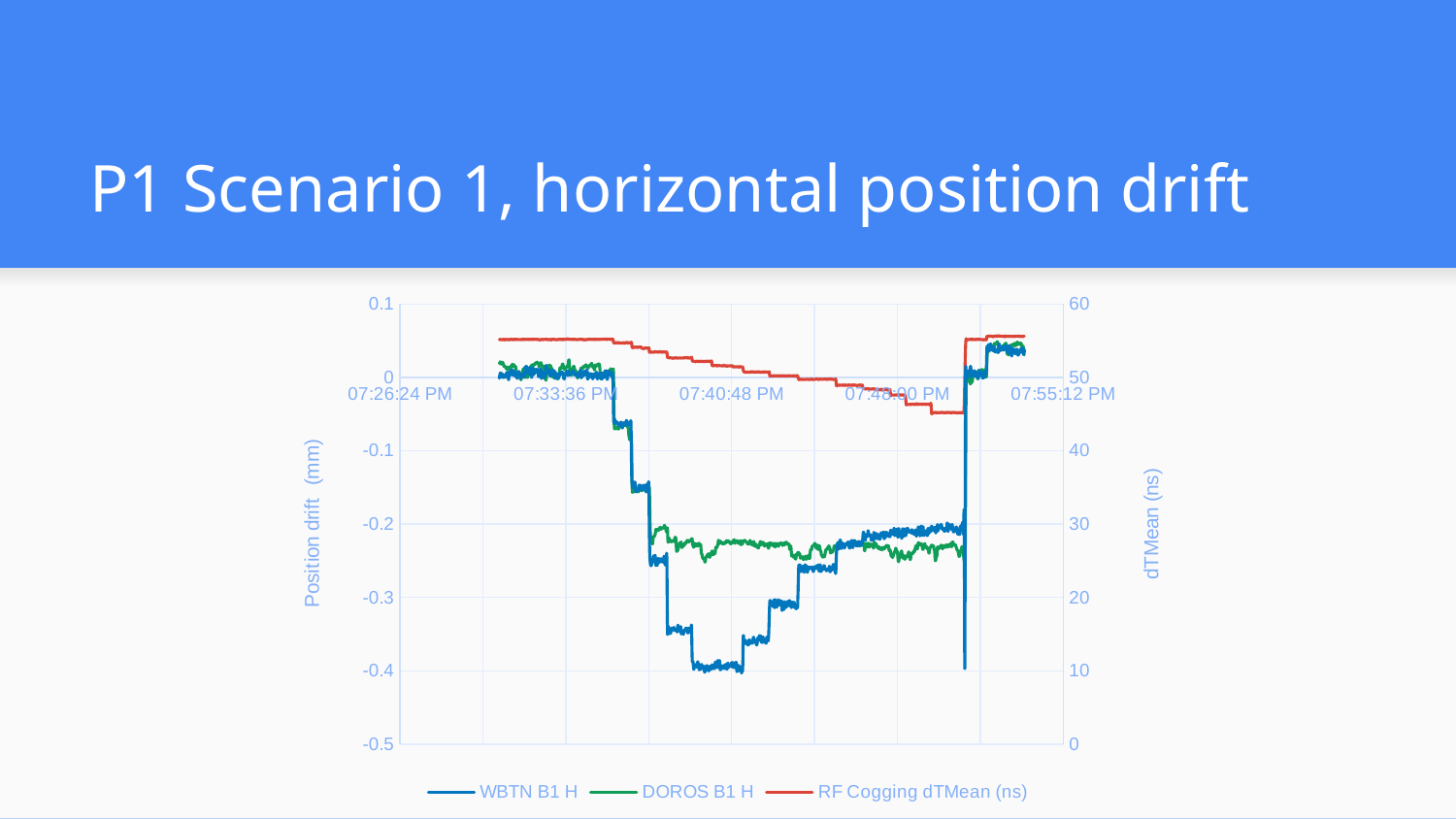
What kind of chart is shown on the slide? line chart Is the value of the RF Cogging dTMean series at 07:33:36 PM greater or less than 50? greater Is the value of the DOROS B1 H series at 07:40:48 PM greater or less than -0.1? less How many series does the chart legend list? 3 Is the lowest value reached by the RF Cogging dTMean series greater or less than 50? less What are the three series named in the legend? WBTN B1 H, DOROS B1 H, RF Cogging dTMean (ns) Between 07:33:36 PM and 07:48:00 PM, does the RF Cogging dTMean series rise or fall? fall Which series reaches the lower position drift, WBTN B1 H or DOROS B1 H? WBTN B1 H How many time labels are shown on the x axis? 5 What is the label of the left vertical axis? Position drift (mm)